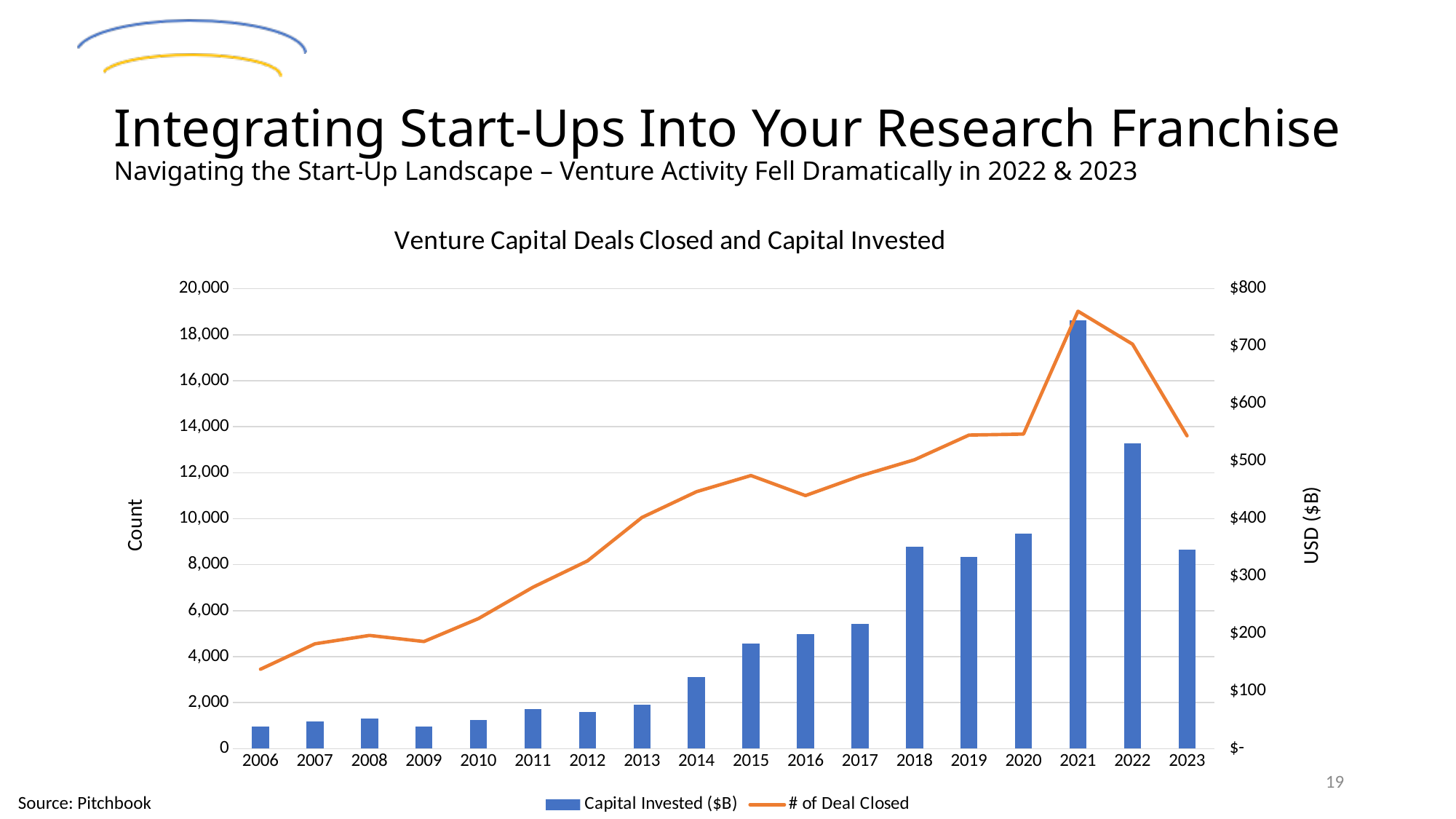
Which year has the larger Capital Invested ($B), 2022 or 2023? 2022 Which year has the highest # of Deal Closed? 2021 Is the Capital Invested ($B) for 2023 greater or less than $400? less Is the Capital Invested ($B) for 2021 greater or less than $700? greater What kind of chart is shown on the slide? A combined bar and line chart How many years are shown on the x axis? 18 Which year has the lowest # of Deal Closed? 2006 Does the # of Deal Closed rise or fall from 2021 to 2023? Fall How many series does the legend list? 2 Which year has the highest Capital Invested ($B)? 2021 Is the # of Deal Closed for 2006 greater or less than 4,000? less